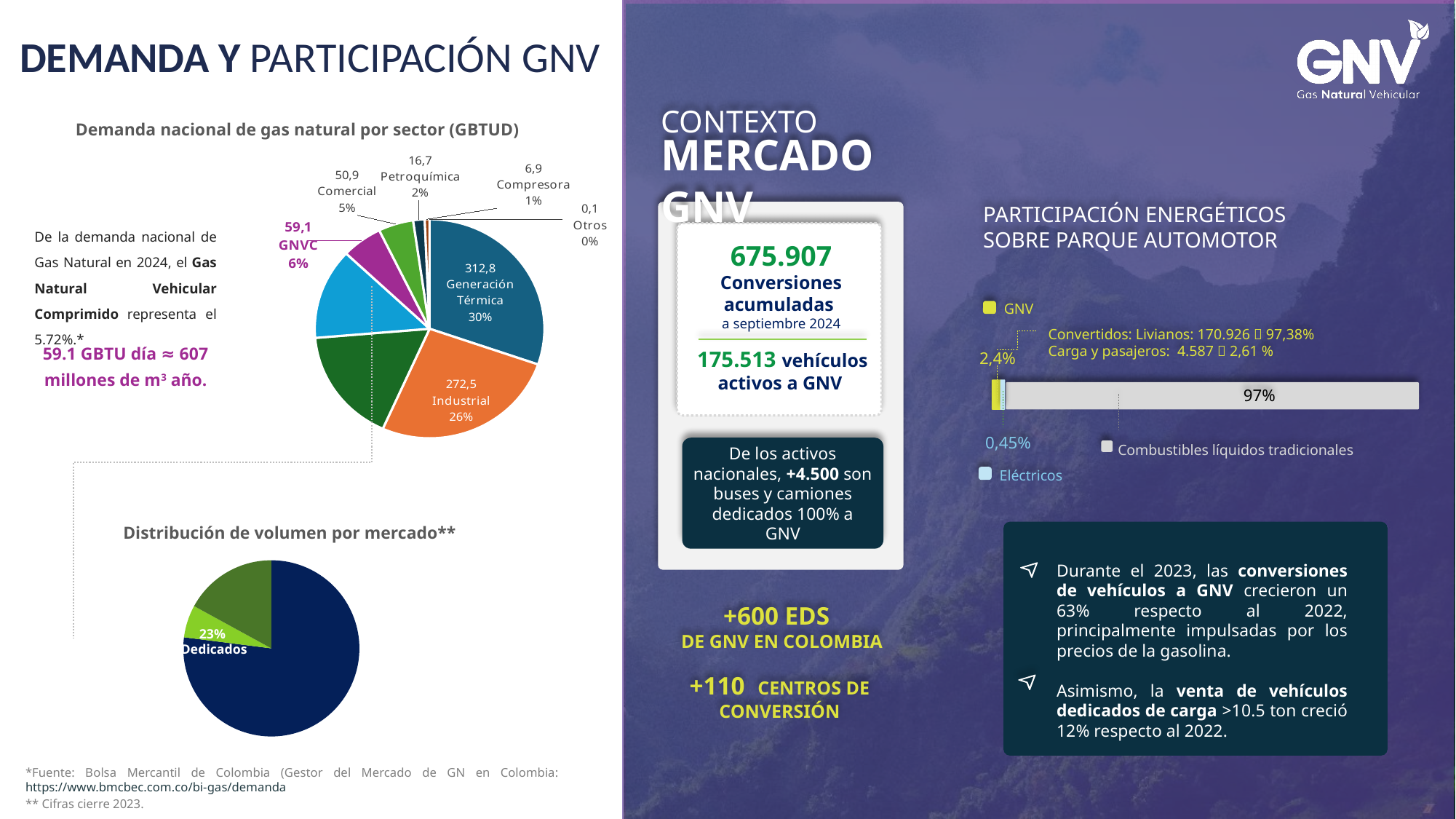
In the chart 'Demanda nacional de gas natural por sector (GBTUD)', which labeled sector has the smallest demand? Otros How many categories does the legend of the chart 'Participación energéticos sobre parque automotor' list? 3 In the chart 'Demanda nacional de gas natural por sector (GBTUD)', what is the value for Generación Térmica? 312,8 In the chart 'Distribución de volumen por mercado', what share does Dedicados have? 23% In the chart 'Demanda nacional de gas natural por sector (GBTUD)', which sector has the largest demand? Generación Térmica In the chart 'Demanda nacional de gas natural por sector (GBTUD)', what is the difference between the Generación Térmica and Industrial values? 40,3 In the chart 'Participación energéticos sobre parque automotor', which category has the largest share? Combustibles líquidos tradicionales What kind of chart is 'Demanda nacional de gas natural por sector (GBTUD)'? Pie chart In the chart 'Demanda nacional de gas natural por sector (GBTUD)', which is larger, Comercial or Petroquímica? Comercial In the chart 'Demanda nacional de gas natural por sector (GBTUD)', what is the value for GNVC? 59,1 In the chart 'Demanda nacional de gas natural por sector (GBTUD)', what percentage share does Industrial have? 26% In the chart 'Participación energéticos sobre parque automotor', what is the share for GNV? 2,4%